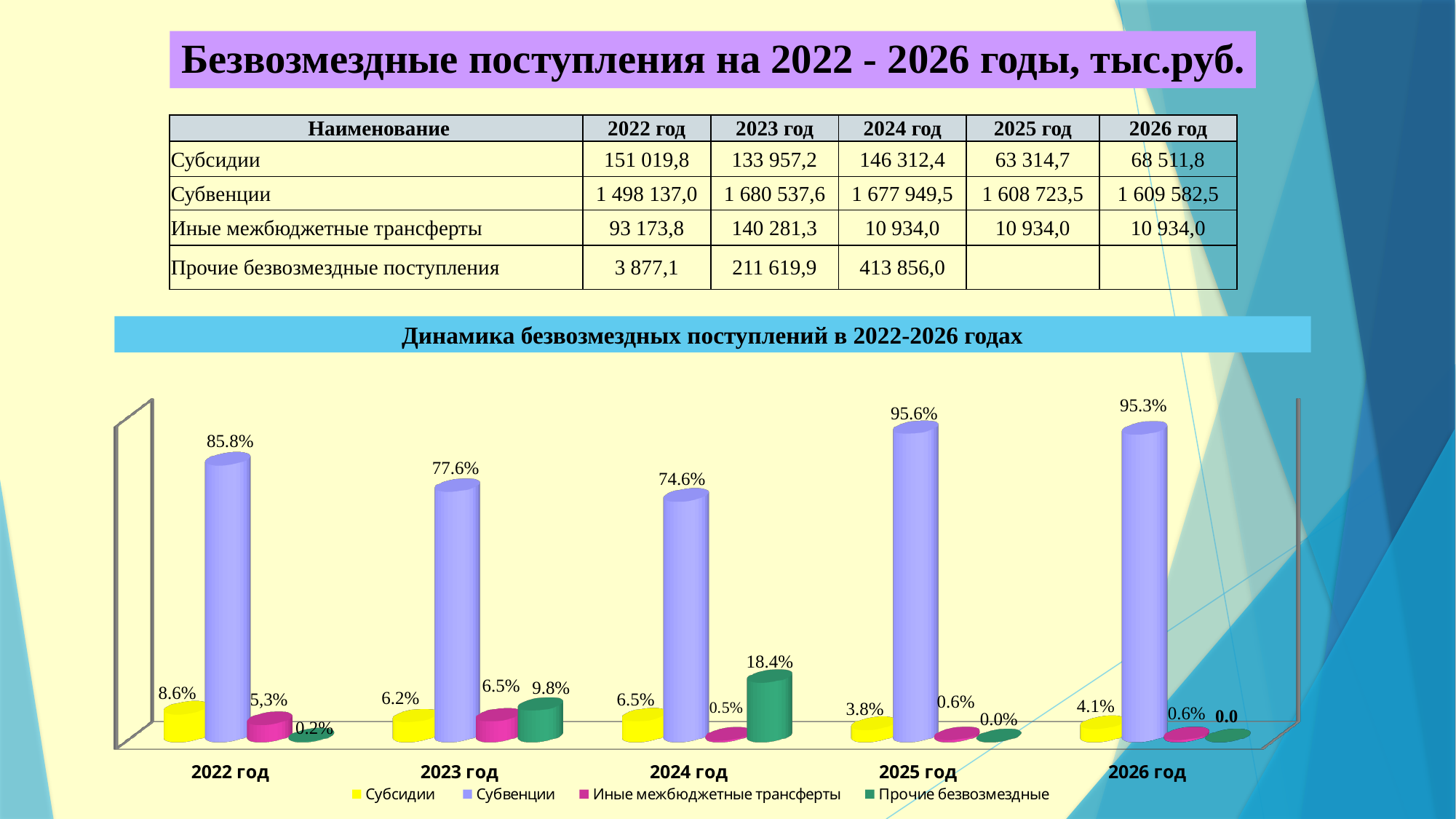
In which year is the value for Субсидии the highest? 2022 год In which year is the value for Субвенции the lowest? 2024 год What is the value for Субвенции in 2022 год in the chart 'Динамика безвозмездных поступлений в 2022-2026 годах'? 85.8% How many series does the chart legend list? 4 What is the value for Субсидии in 2025 год? 3.8% Does the value for Субвенции rise or fall from 2022 год to 2024 год? fall What is the value for Прочие безвозмездные in 2024 год? 18.4% How many years are shown on the x axis of the chart? 5 What is the difference between the Субвенции values for 2025 год and 2022 год? 9.8 percentage points What is the value for Иные межбюджетные трансферты in 2023 год? 6.5% In 2023 год, which is larger: Прочие безвозмездные or Иные межбюджетные трансферты? Прочие безвозмездные In which year is the value for Субвенции the highest? 2025 год